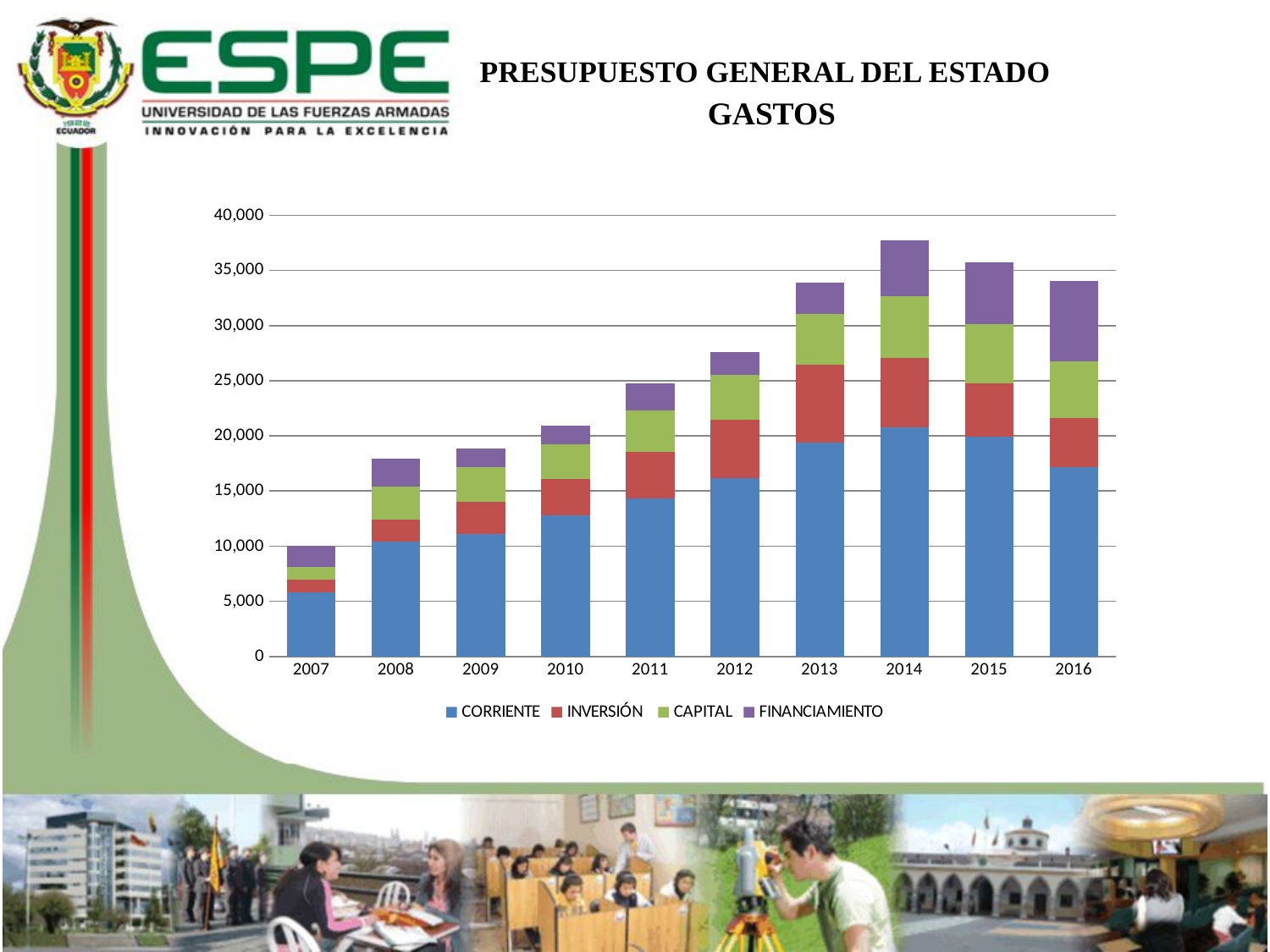
Which year has the lowest total bar in the chart? 2007 Which series is shown in blue in the chart? CORRIENTE Is the CORRIENTE value for 2012 greater or less than 15,000? greater Which year has the highest total bar in the chart? 2014 Is the total bar for 2007 greater or less than 15,000? less How many years are shown on the x axis of the chart? 10 What kind of chart is shown on the slide? Stacked bar chart Do the total bars rise or fall from 2007 to 2014? rise Is the total bar for 2012 greater or less than 25,000? greater Which year has the larger total bar, 2015 or 2016? 2015 How many series does the chart's legend list? 4